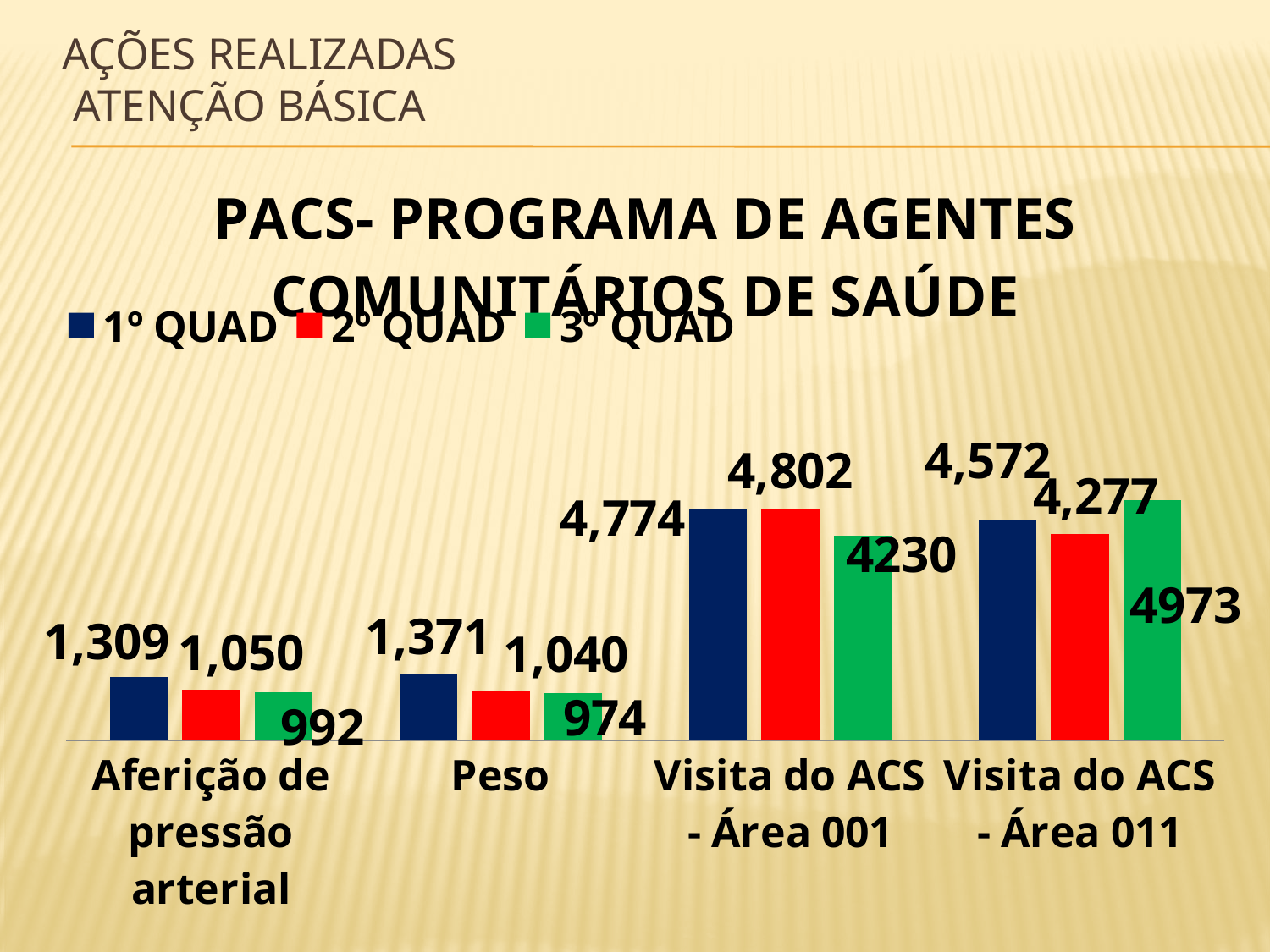
Which is larger for Visita do ACS - Área 001: the 1º QUAD value or the 3º QUAD value? 1º QUAD How many series does the legend list? 3 Which category has the lowest value for 3º QUAD? Peso What is the title of the chart? PACS- PROGRAMA DE AGENTES COMUNITÁRIOS DE SAÚDE What is the difference between the 1º QUAD and 2º QUAD values for Aferição de pressão arterial? 259 What is the value for 3º QUAD in the category Visita do ACS - Área 011? 4973 What is the value for 1º QUAD in the category Aferição de pressão arterial? 1,309 How many categories are shown on the x axis? 4 Which series is shown in red in the legend? 2º QUAD What type of chart is shown on the slide? bar chart What is the value for 2º QUAD in the category Visita do ACS - Área 001? 4,802 What is the value for 3º QUAD in the category Peso? 974